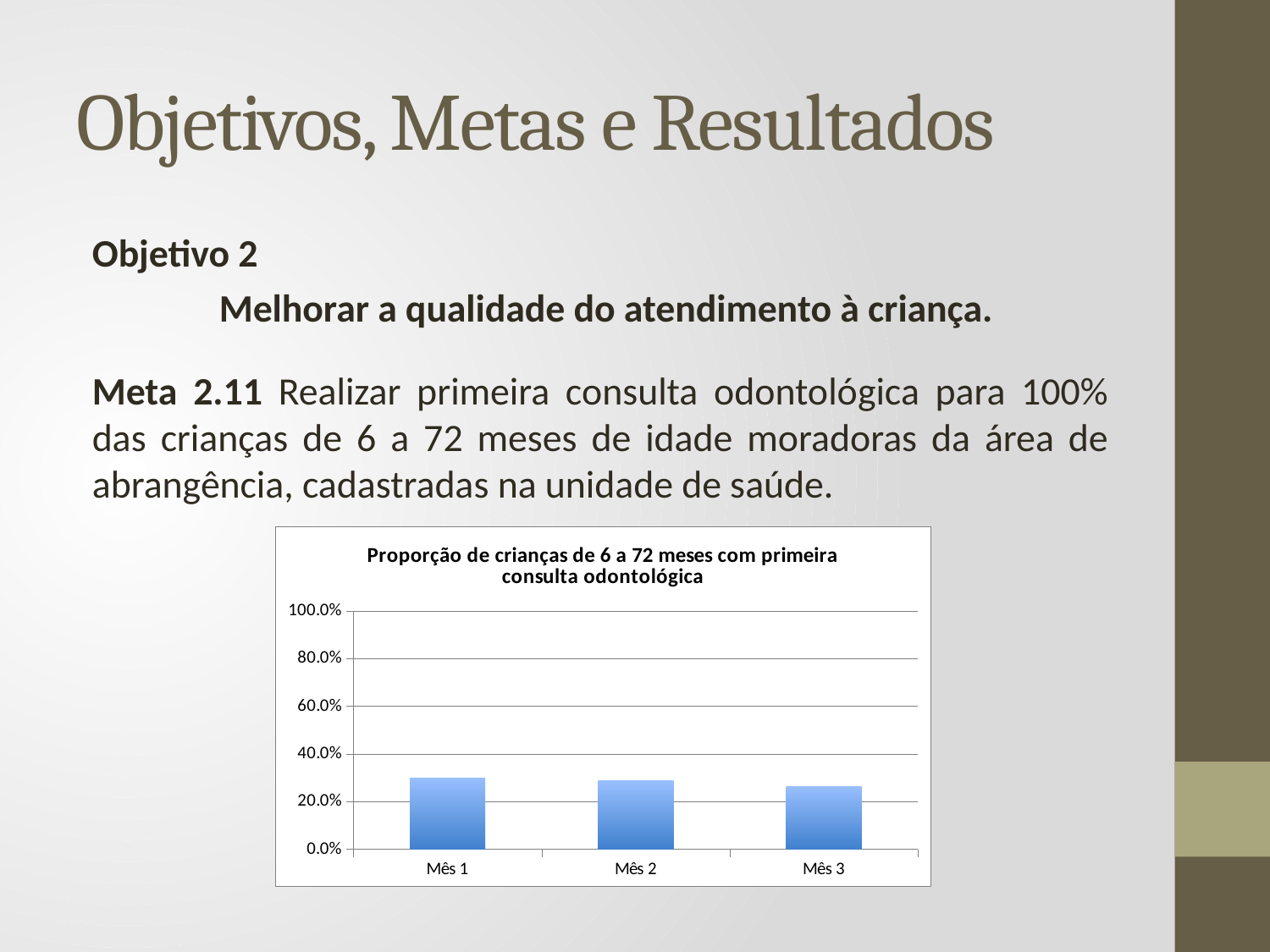
How many categories are shown on the x axis of the chart? 3 Is the value for Mês 1 greater or less than 20.0%? greater Which is larger, the value for Mês 1 or the value for Mês 3? Mês 1 Is the value for Mês 3 greater or less than 20.0%? greater What kind of chart is shown on the slide? bar chart Is the value for Mês 1 greater or less than 40.0%? less Which is larger, the value for Mês 2 or the value for Mês 3? Mês 2 Which category has the lowest value in the chart? Mês 3 What is the highest value shown on the y axis of the chart? 100.0% What is the title of the chart? Proporção de crianças de 6 a 72 meses com primeira consulta odontológica Do the values rise or fall from Mês 1 to Mês 3? fall